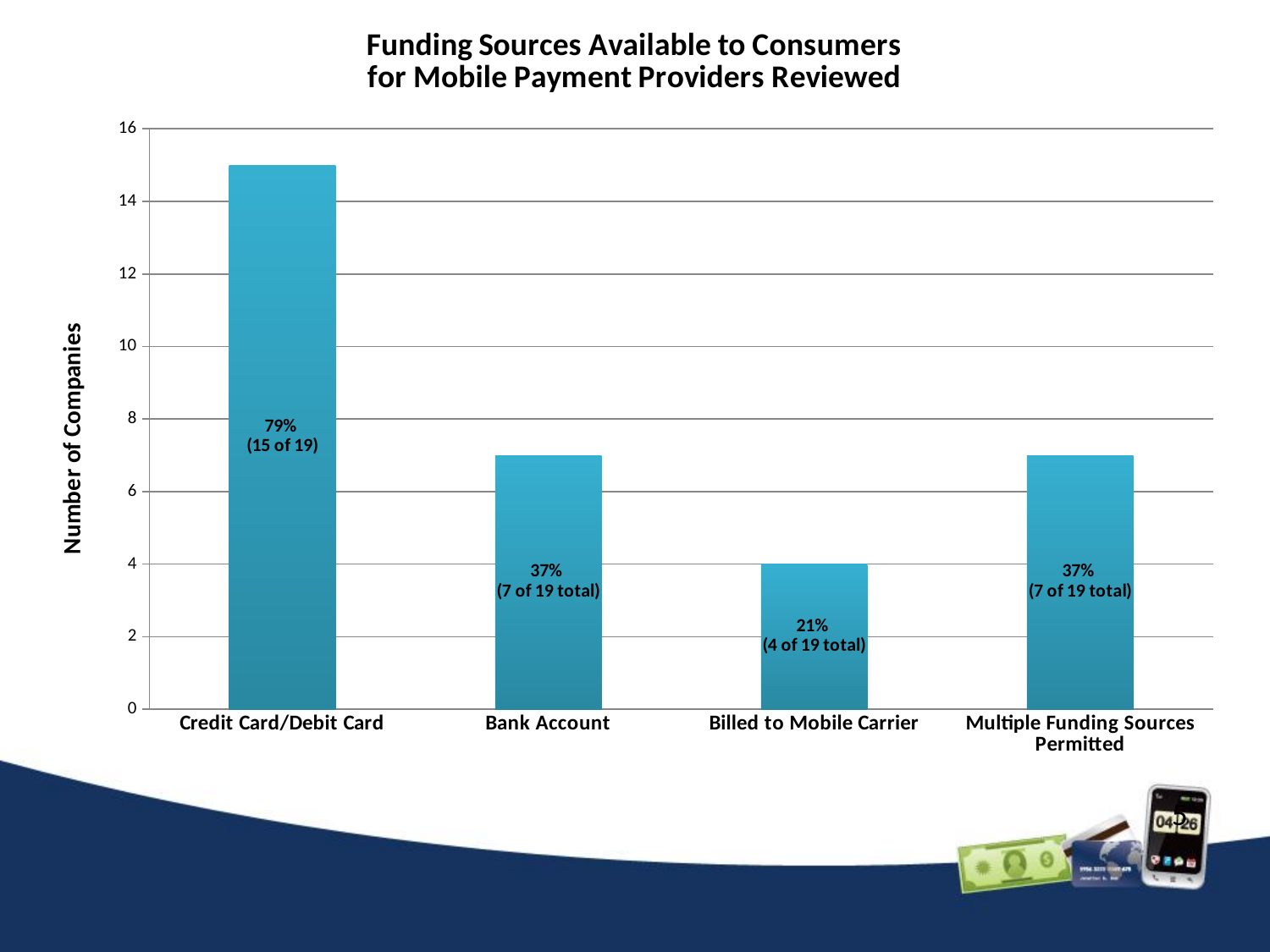
What type of chart is shown on the slide? bar chart Which funding source has the highest number of companies? Credit Card/Debit Card How many companies offer Credit Card/Debit Card as a funding source? 15 Is the value for Credit Card/Debit Card greater or less than 14? greater How many funding source categories are shown on the x axis? 4 Which has more companies, Bank Account or Billed to Mobile Carrier? Bank Account What percentage of companies permit multiple funding sources? 37% Which funding source has the lowest number of companies? Billed to Mobile Carrier What percentage label is shown on the Bank Account bar? 37% What is the label on the y axis? Number of Companies What is the difference in number of companies between Credit Card/Debit Card and Bank Account? 8 How many companies are billed to mobile carrier? 4